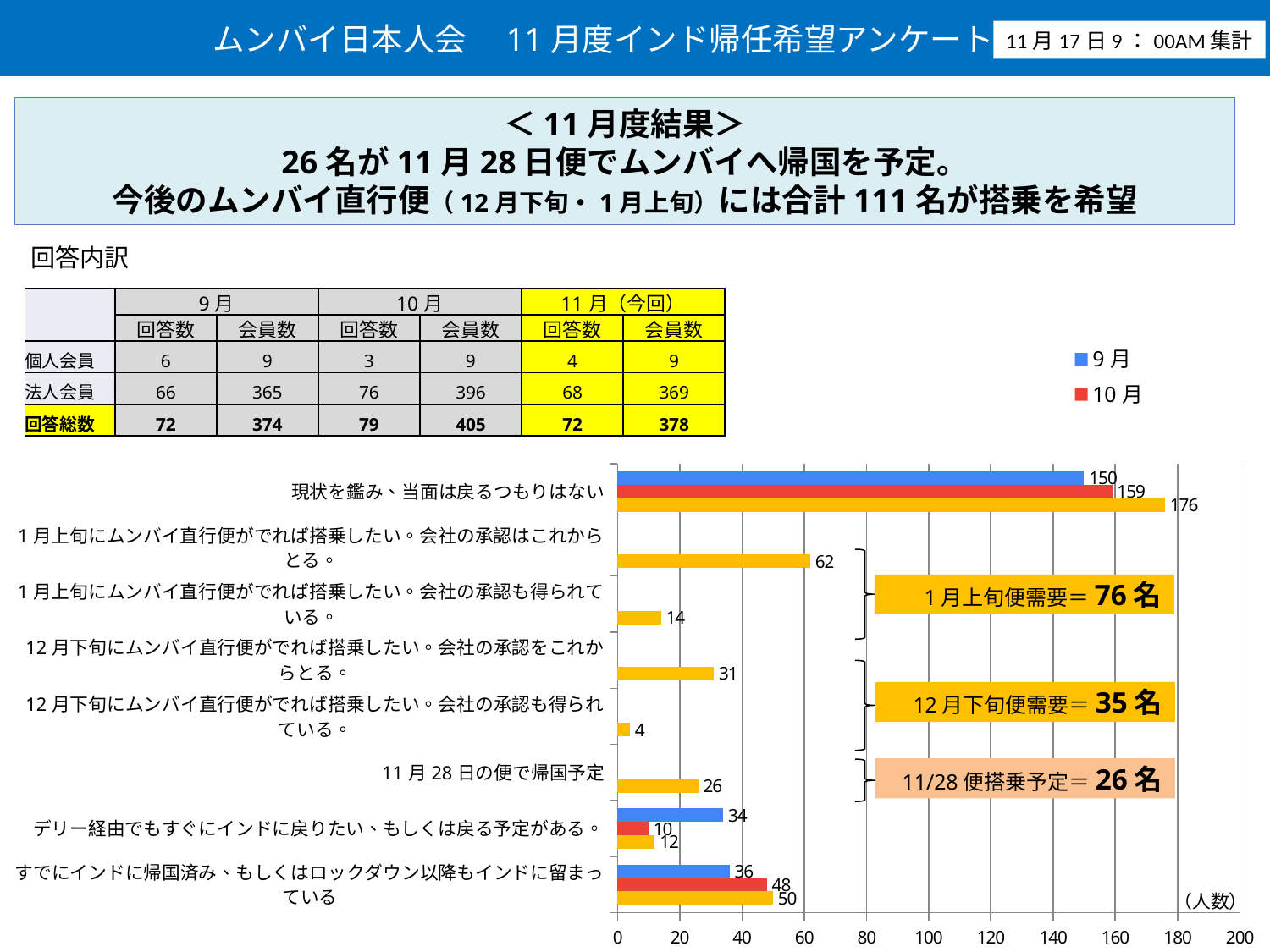
What is the value of the yellow bar for 1月上旬にムンバイ直行便がでれば搭乗したい。会社の承認はこれからとる。? 62 For デリー経由でもすぐにインドに戻りたい、もしくは戻る予定がある。, which is larger: the 9月 bar or the 10月 bar? 9月 What type of chart is shown on the slide? bar chart What is the value of the 9月 (blue) bar for 現状を鑑み、当面は戻るつもりはない? 150 Which category has the highest yellow bar value? 現状を鑑み、当面は戻るつもりはない What is the value of the 10月 (red) bar for 現状を鑑み、当面は戻るつもりはない? 159 How many series does the chart legend list? 2 What is the value of the yellow bar for 11月28日の便で帰国予定? 26 How many categories are shown on the chart's vertical axis? 8 What is the difference between the yellow bar (176) and the 9月 bar (150) for 現状を鑑み、当面は戻るつもりはない? 26 What unit label is shown at the end of the chart's horizontal axis? (人数) Which category has the lowest yellow bar value? 12月下旬にムンバイ直行便がでれば搭乗したい。会社の承認も得られている。